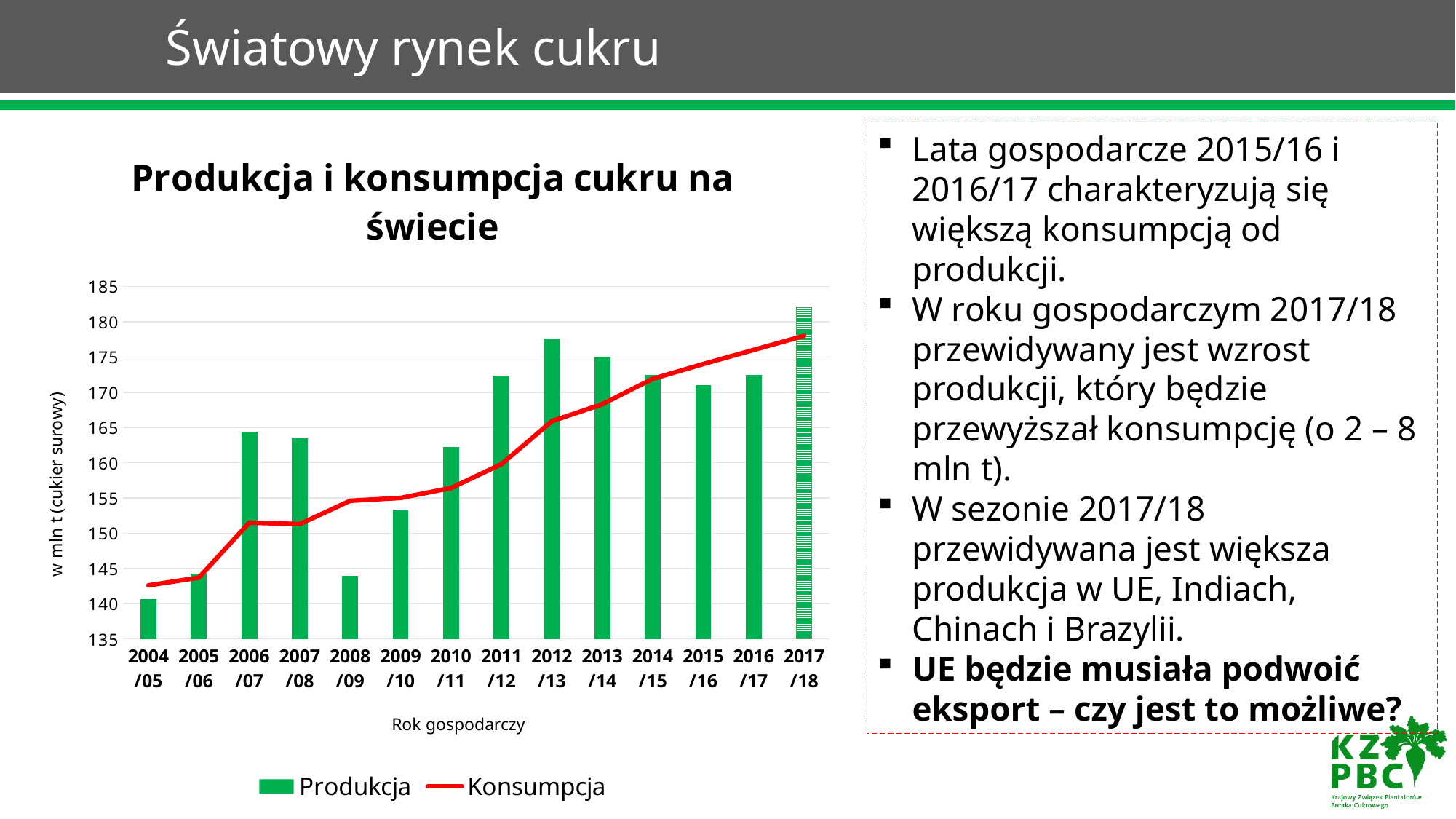
What is the label of the y axis? w mln t (cukier surowy) Is the Produkcja value for 2017/18 greater or less than 180? greater Which year has the lowest Produkcja bar? 2004/05 Which year has the larger Produkkcja bar, 2012/13 or 2013/14? 2012/13 Is the Produkcja value for 2012/13 greater or less than 175? greater Is the Produkcja value for 2008/09 greater or less than 150? less Which year has the larger Produkcja bar, 2010/11 or 2011/12? 2011/12 How many series does the legend list? 2 Does the Konsumpcja line generally rise or fall from 2004/05 to 2017/18? rise How many years (categories) are shown on the x axis? 14 Which year has the highest Produkcja bar? 2017/18